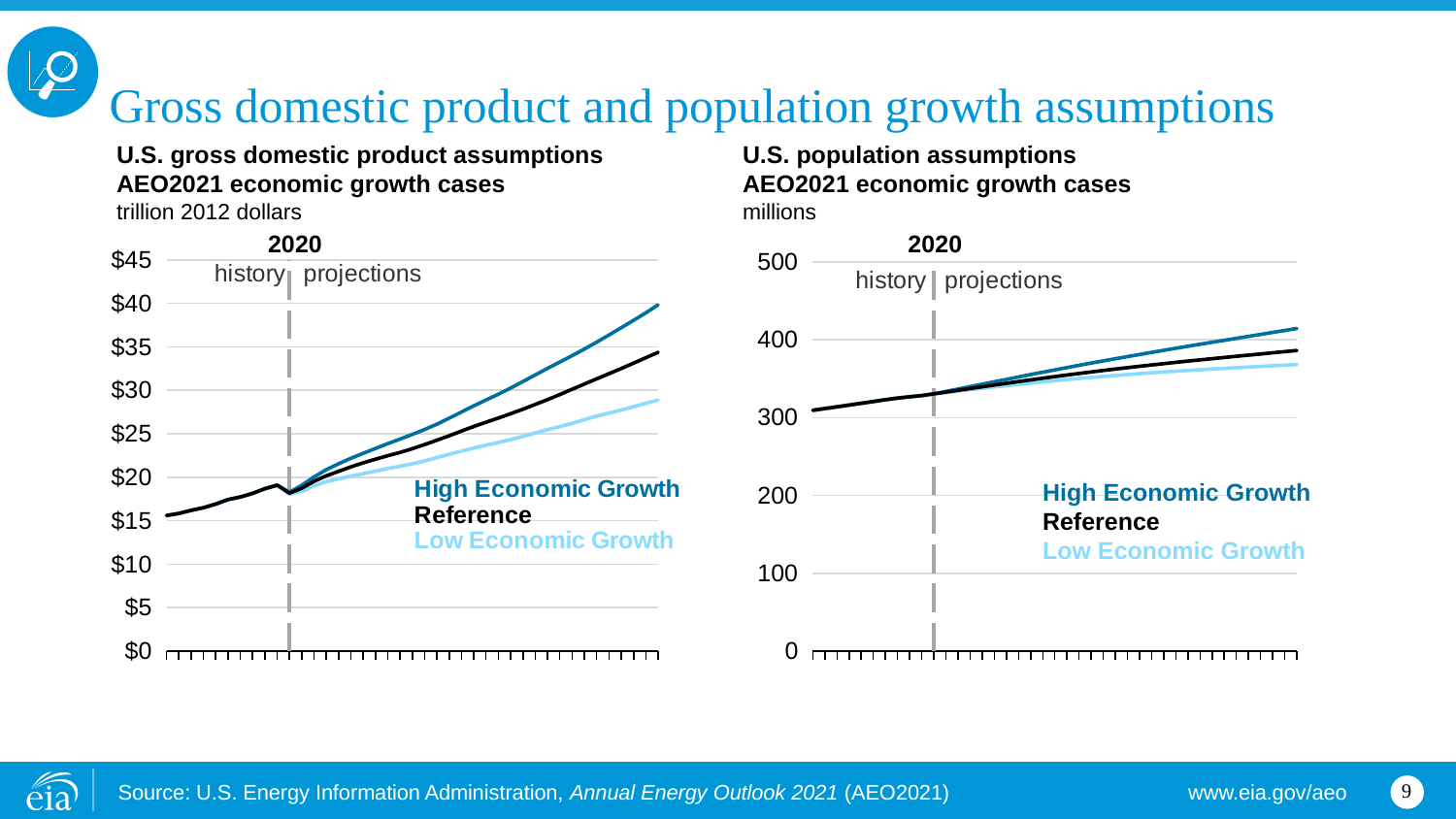
How many series (economic growth cases) are shown on the U.S. gross domestic product assumptions chart? 3 On the U.S. gross domestic product assumptions chart, do the projected values rise or fall over time after 2020? rise On the U.S. population assumptions chart, which line is higher at the end of the projection period, High Economic Growth or Low Economic Growth? High Economic Growth What unit is used on the U.S. gross domestic product assumptions chart? trillion 2012 dollars On the U.S. gross domestic product assumptions chart, is the value of the High Economic Growth line at the end of the projection period greater or less than $35? greater On the U.S. population assumptions chart, is the value of the Low Economic Growth line at the end of the projection period greater or less than 400? less On the U.S. population assumptions chart, is the value of the High Economic Growth line at the end of the projection period greater or less than 400? greater How many series (economic growth cases) are shown on the U.S. population assumptions chart? 3 What kind of chart is the U.S. gross domestic product assumptions chart on the left? line chart What kind of chart is the U.S. population assumptions chart on the right? line chart